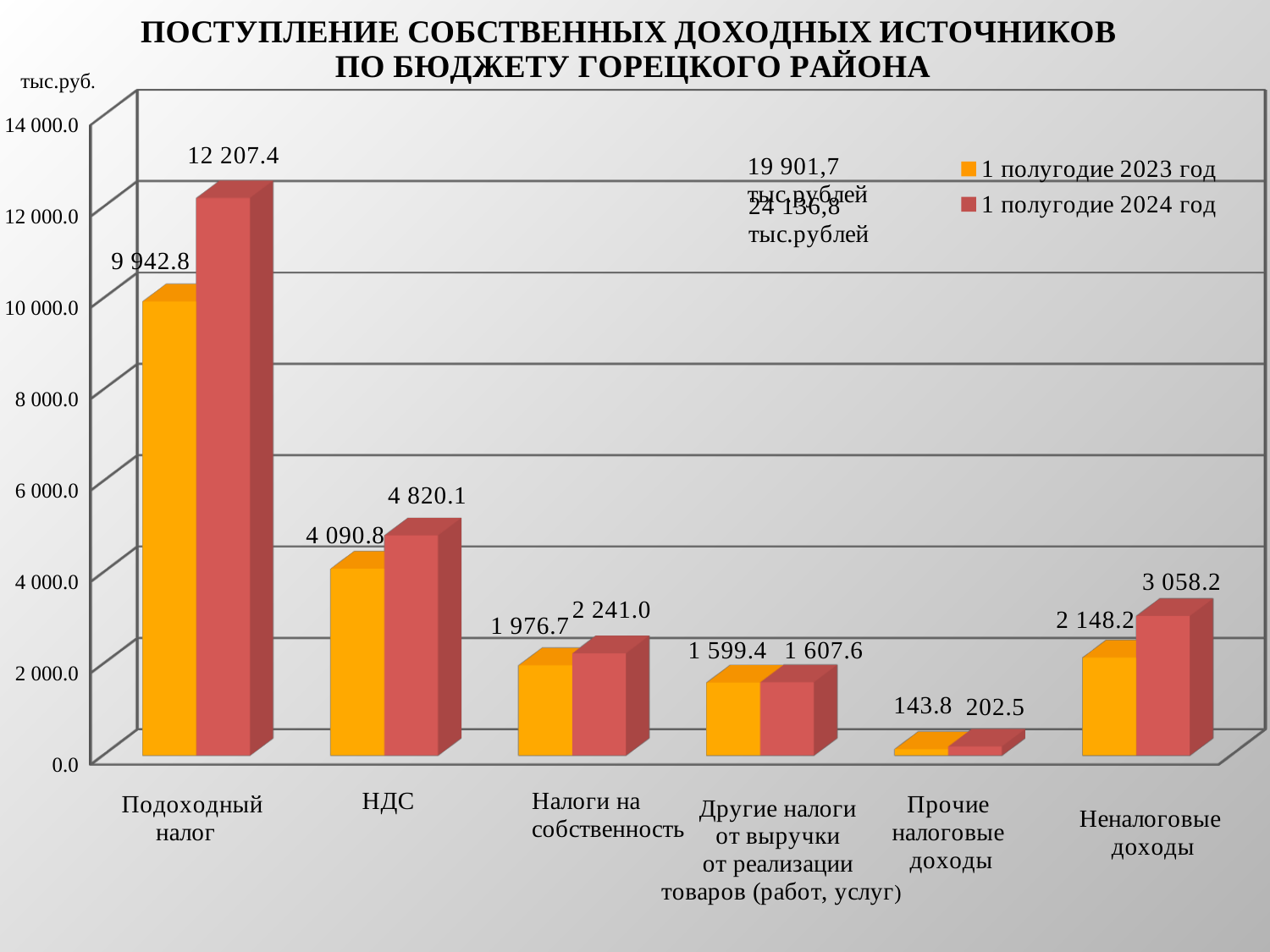
What is the value for Подоходный налог in the series 1 полугодие 2024 год? 12 207.4 How many series does the legend list? 2 What kind of chart is shown on the slide? Bar chart What is the value for Неналоговые доходы in the series 1 полугодие 2024 год? 3 058.2 Which is larger for НДС: the value for 1 полугодие 2023 год or for 1 полугодие 2024 год? 1 полугодие 2024 год What is the difference between the 1 полугодие 2024 год and 1 полугодие 2023 год values for Неналоговые доходы? 910.0 How many categories are shown on the x axis? 6 What is the value for Прочие налоговые доходы in the series 1 полугодие 2023 год? 143.8 What is the value for НДС in the series 1 полугодие 2023 год? 4 090.8 What is the difference between the 1 полугодие 2024 год and 1 полугодие 2023 год values for Подоходный налог? 2 264.6 Which category has the lowest value in the series 1 полугодие 2023 год? Прочие налоговые доходы Which category has the highest value in the series 1 полугодие 2024 год? Подоходный налог